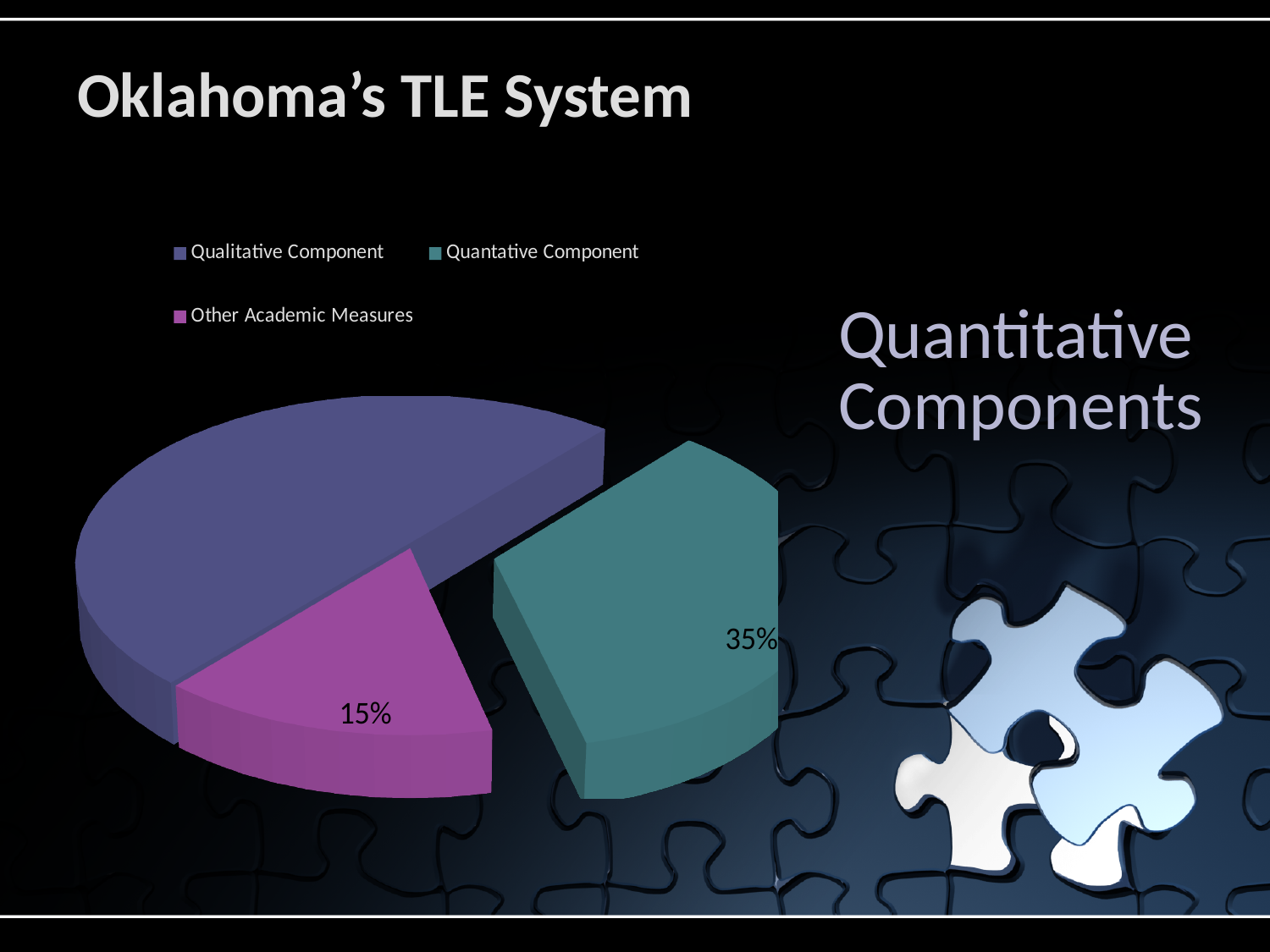
Which slice of the pie is the largest? Qualitative Component What percentage is shown for the Other Academic Measures slice? 15% What share of the pie does the Quantative Component slice represent? 35% Which is larger, the Quantative Component slice or the Other Academic Measures slice? Quantative Component What kind of chart is shown on the slide? pie chart What is the difference in percentage points between the Quantative Component and Other Academic Measures slices? 20 What colour is the Other Academic Measures slice? magenta/pink How many slices does the pie chart have? 3 Which slice of the pie is the smallest? Other Academic Measures Which is larger, the Qualitative Component slice or the Quantative Component slice? Qualitative Component What percentage is shown for the Quantative Component slice? 35% How many entries does the chart legend list? 3